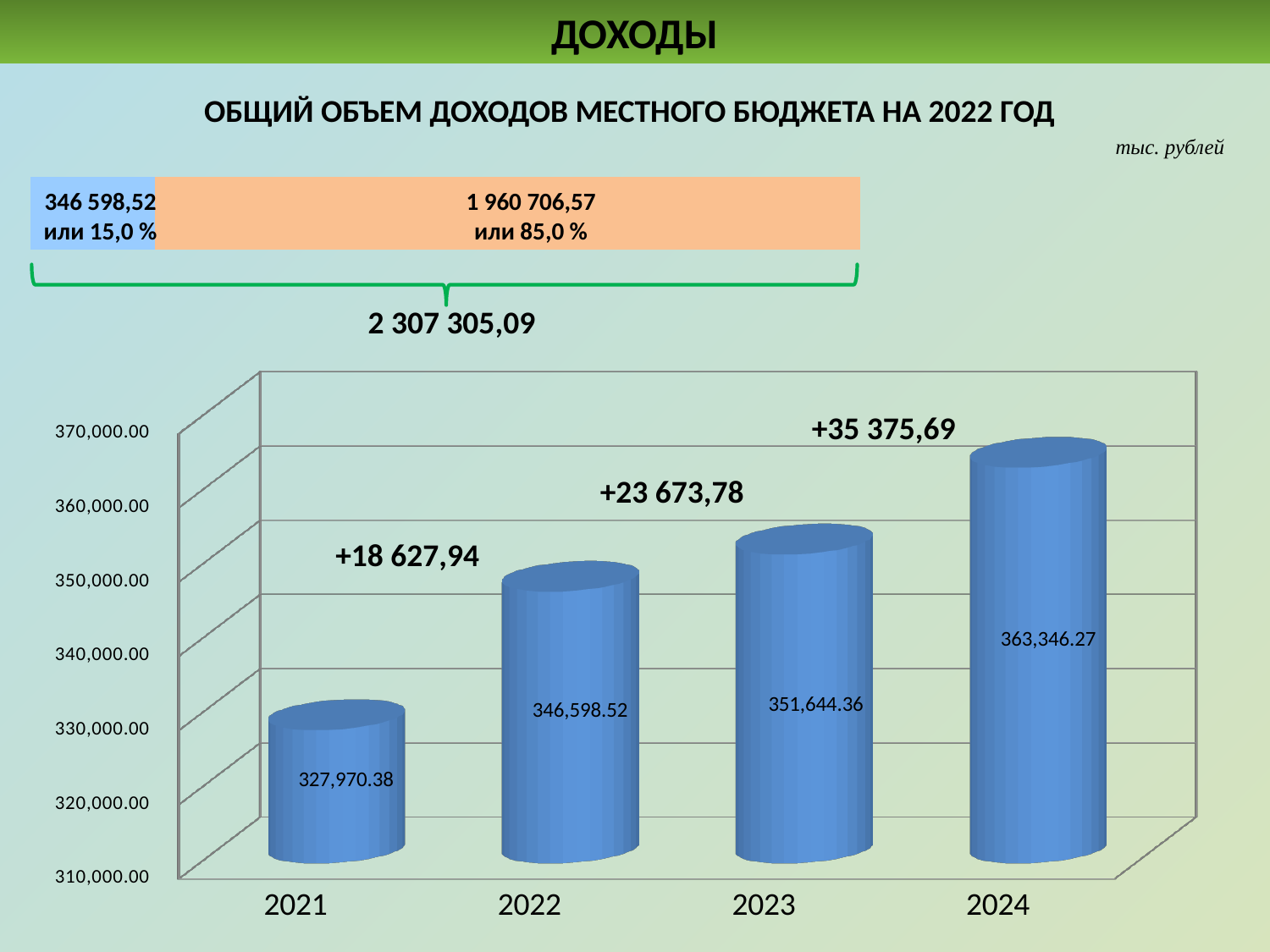
What is the value for 2021 in the bar chart? 327,970.38 What is the value for 2022 in the bar chart? 346,598.52 What is the difference between the values for 2023 and 2022 in the bar chart? 5,045.84 Is the value for 2024 in the bar chart greater or less than 360,000.00? greater Which is larger in the bar chart, the value for 2023 or the value for 2022? 2023 What is the total shown under the stacked bar at the top of the slide? 2 307 305,09 Do the values in the bar chart rise or fall from 2021 to 2024? rise How many years are shown on the x axis of the bar chart? 4 Which year has the highest value in the bar chart? 2024 What is the value for 2024 in the bar chart? 363,346.27 What kind of chart is shown at the bottom of the slide? bar chart Which year has the lowest value in the bar chart? 2021